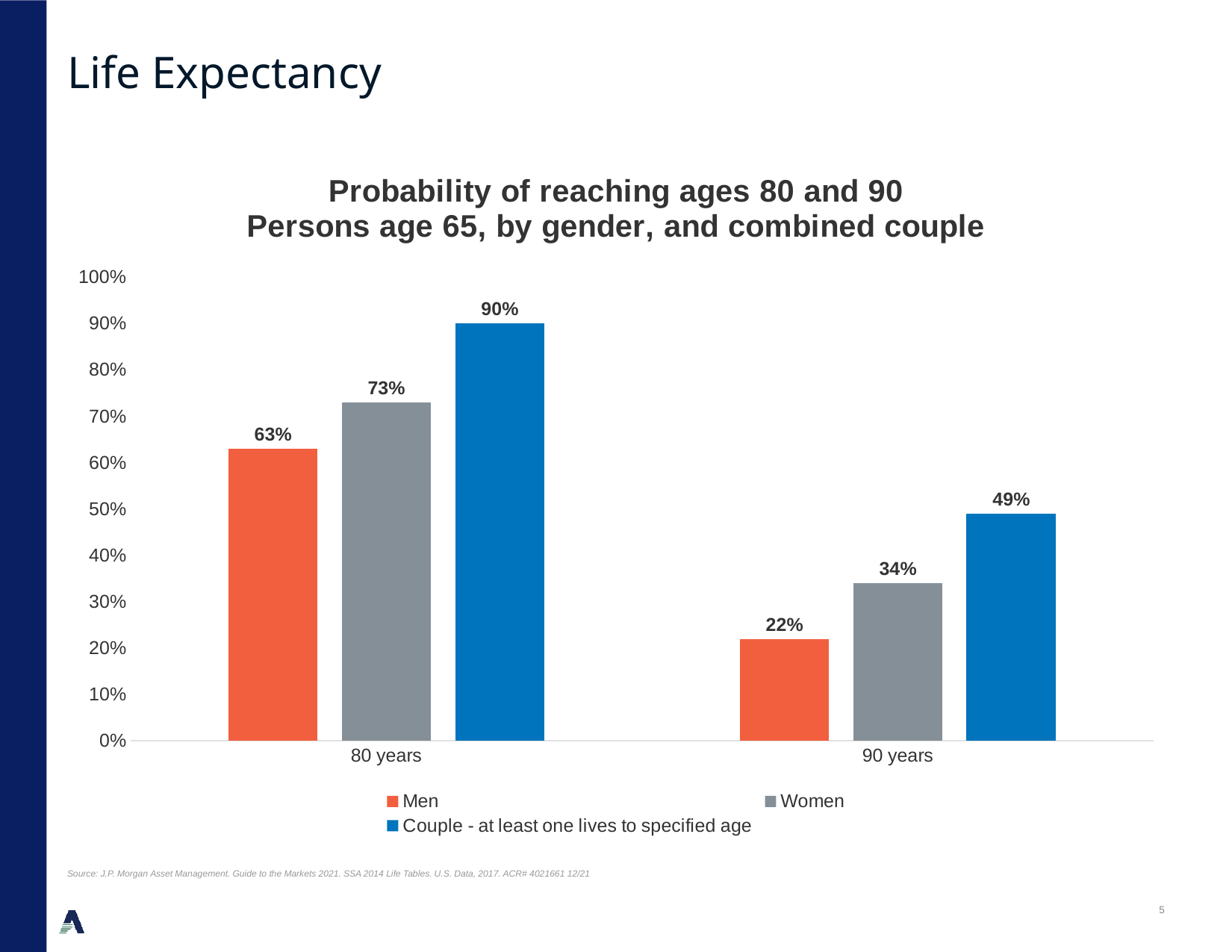
How many age categories are shown on the x axis? 2 What is the probability that a man aged 65 reaches age 80? 63% How many series does the legend list? 3 Which series has the highest value at 90 years? Couple - at least one lives to specified age What is the probability that a woman aged 65 reaches age 90? 34% What is the difference between the Women and Men values at 80 years? 10% What colour are the bars for the Men series? Orange Which series has the lowest value at 80 years? Men What kind of chart is shown on the slide? Bar chart What is the value for the Couple series at 80 years? 90% What is the difference between the Couple values at 80 years and 90 years? 41% Which is larger: the Men value at 90 years or the Women value at 90 years? Women